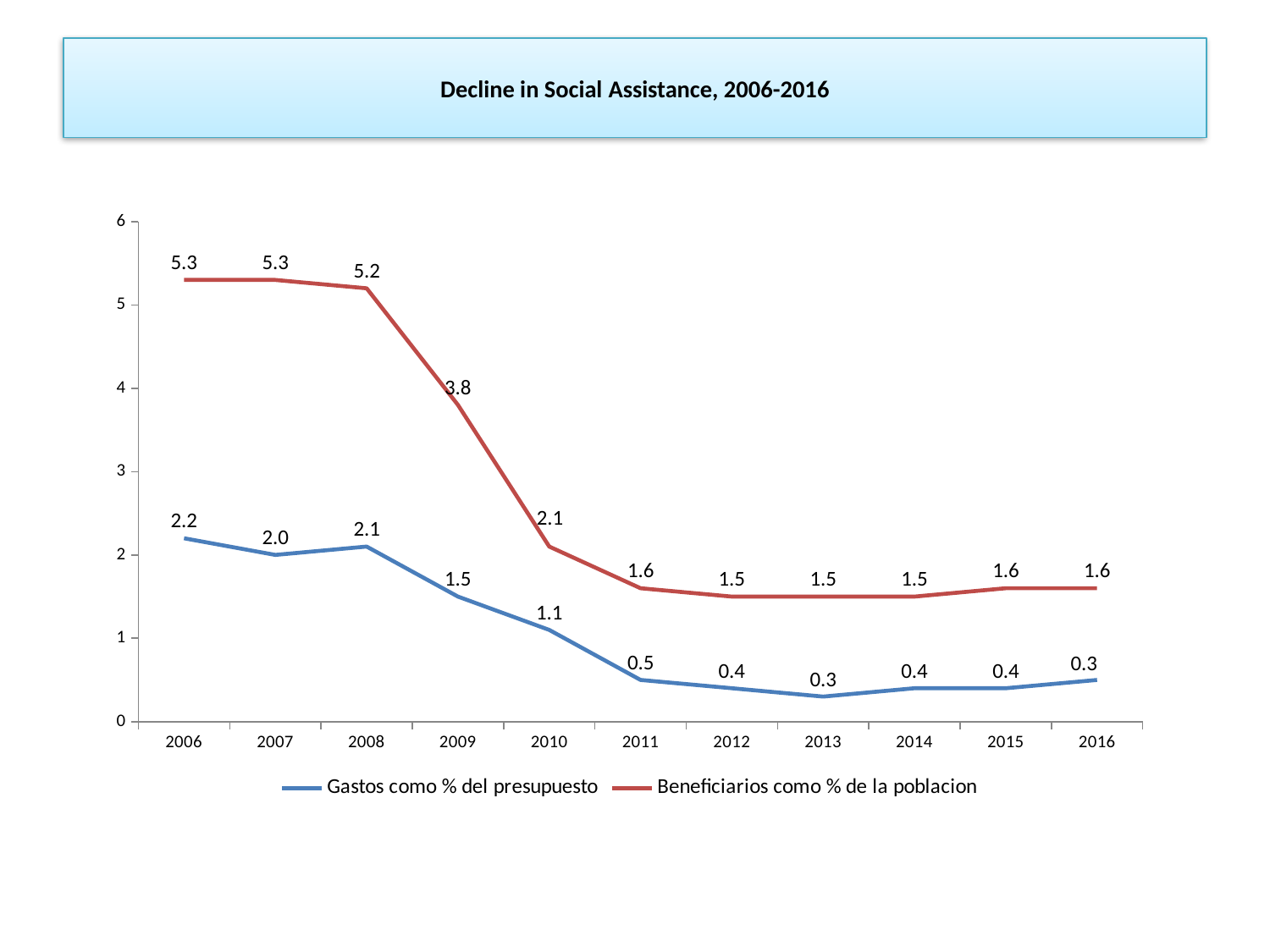
What is the difference between Beneficiarios como % de la poblacion in 2008 and 2009? 1.4 What is the value of Gastos como % del presupuesto in 2016? 0.3 How many years are shown on the x axis? 11 What kind of chart is shown on the slide? Line chart What is the value of Beneficiarios como % de la poblacion in 2009? 3.8 What is the difference between Beneficiarios como % de la poblacion and Gastos como % del presupuesto in 2006? 3.1 What is the title of the chart? Decline in Social Assistance, 2006-2016 What is the value of Gastos como % del presupuesto in 2010? 1.1 Does Beneficiarios como % de la poblacion rise or fall from 2006 to 2016? Fall How many series does the legend list? 2 In which year is Gastos como % del presupuesto lowest? 2013 Which is larger in 2011: Gastos como % del presupuesto or Beneficiarios como % de la poblacion? Beneficiarios como % de la poblacion